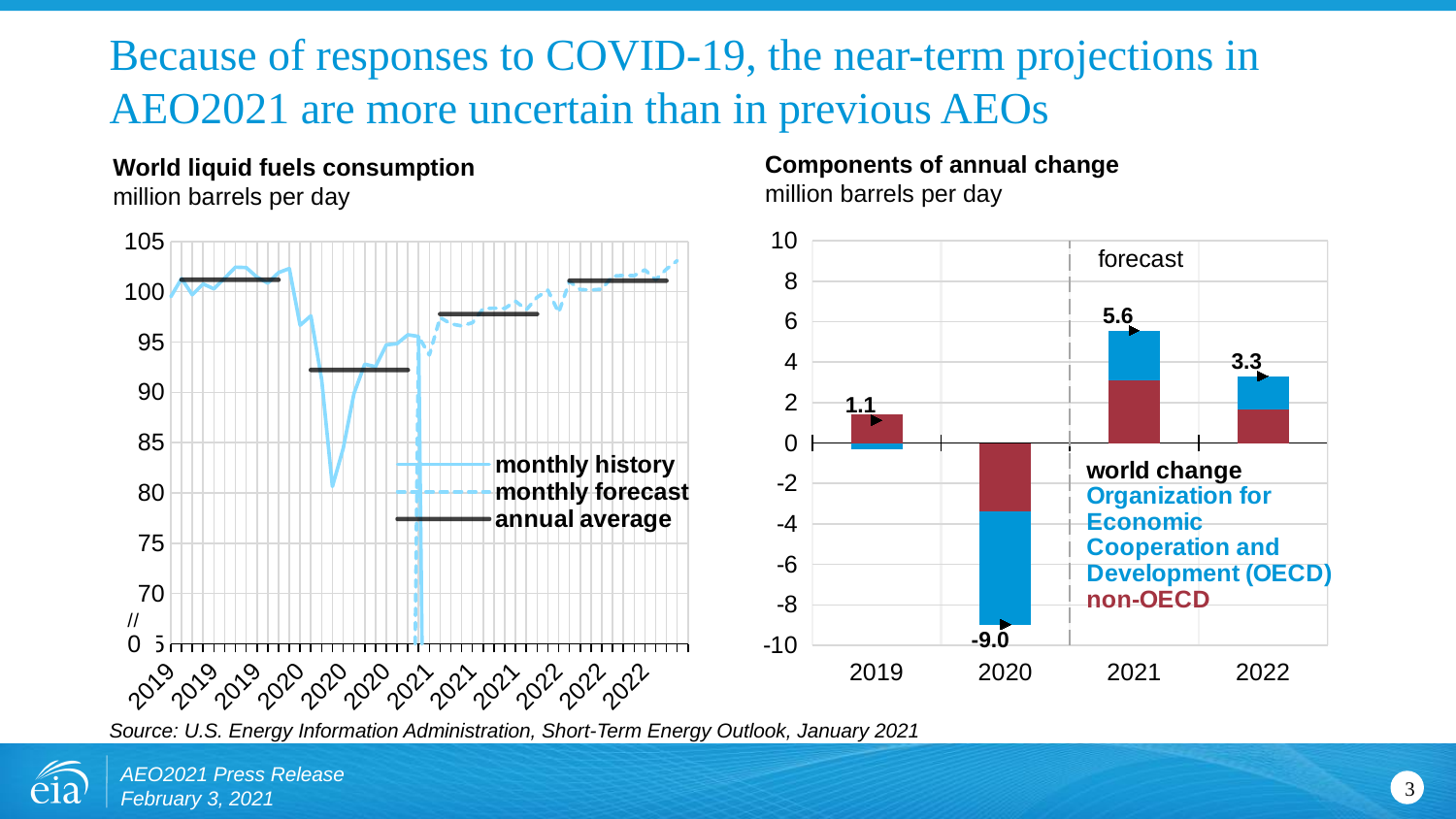
In the 'Components of annual change' chart, which year has the larger world change, 2019 or 2022? 2022 What kind of chart is the 'World liquid fuels consumption' chart? Line chart In the 'Components of annual change' chart, what is the difference between the world change in 2021 and in 2022? 2.3 In the 'Components of annual change' chart, which year has the lowest world change? 2020 What kind of chart is the 'Components of annual change' chart? Bar chart In the 'Components of annual change' chart, which years fall in the forecast period? 2021 and 2022 How many series does the legend of the 'World liquid fuels consumption' chart list? 3 In the 'World liquid fuels consumption' chart, is the annual average for 2020 greater or less than 95 million barrels per day? less In the 'Components of annual change' chart, what is the world change value for 2021? 5.6 In the 'Components of annual change' chart, what is the world change value for 2020? -9.0 In the 'Components of annual change' chart, which year has the highest world change? 2021 How many years are shown on the x axis of the 'Components of annual change' chart? 4